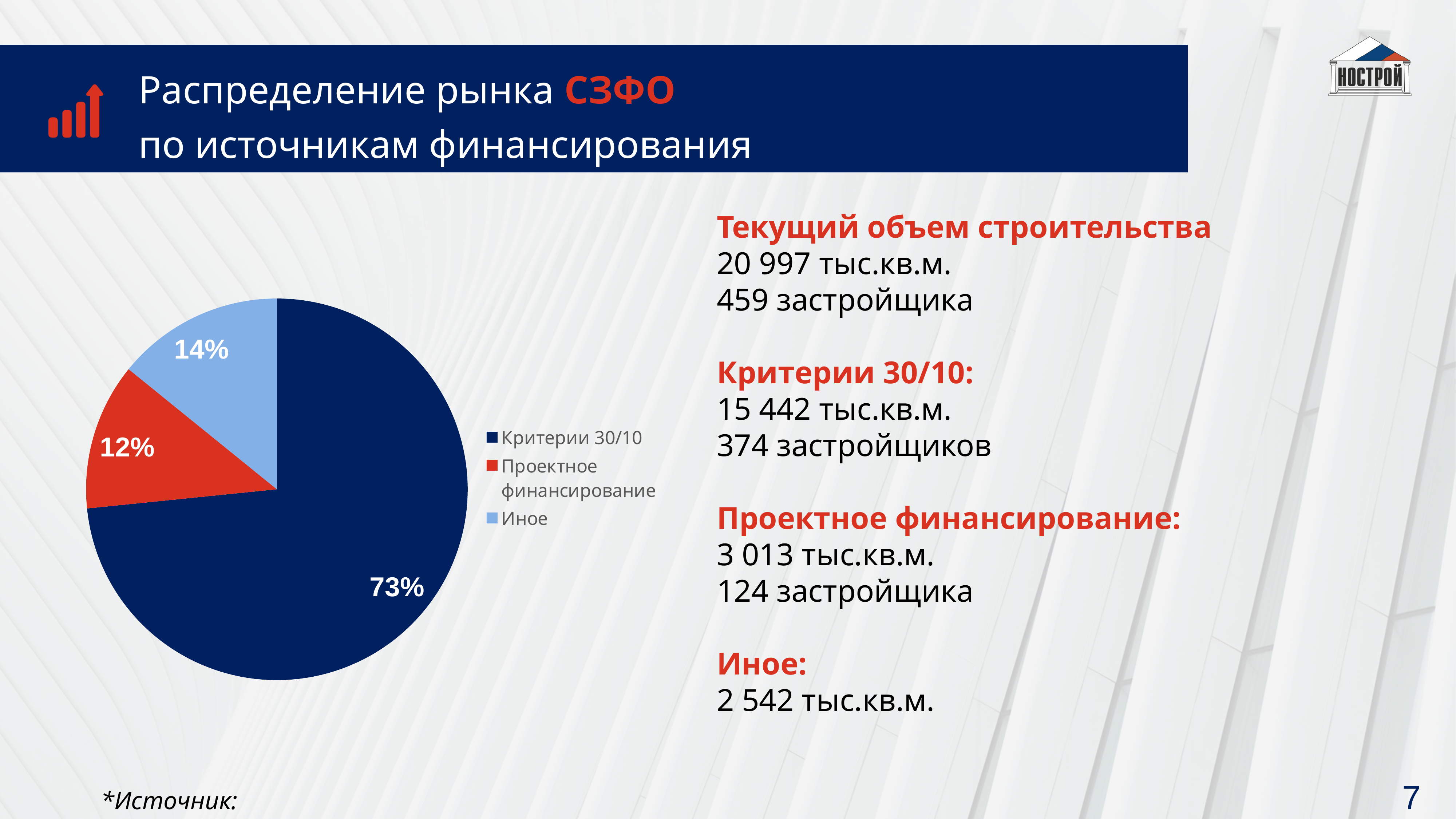
What is the difference in percentage points between the Критерии 30/10 slice and the Иное slice? 59 What colour is the Проектное финансирование slice? red What share of the pie does Критерии 30/10 have? 73% What share of the pie does Проектное финансирование have? 12% How many slices does the pie chart have? 3 Which category has the largest slice of the pie? Критерии 30/10 Which category has the smallest slice of the pie? Проектное финансирование How many entries does the legend list? 3 What share of the pie does Иное have? 14% What colour is the Иное slice? light blue What kind of chart is shown on the slide? pie chart Which slice is larger, Иное or Проектное финансирование? Иное